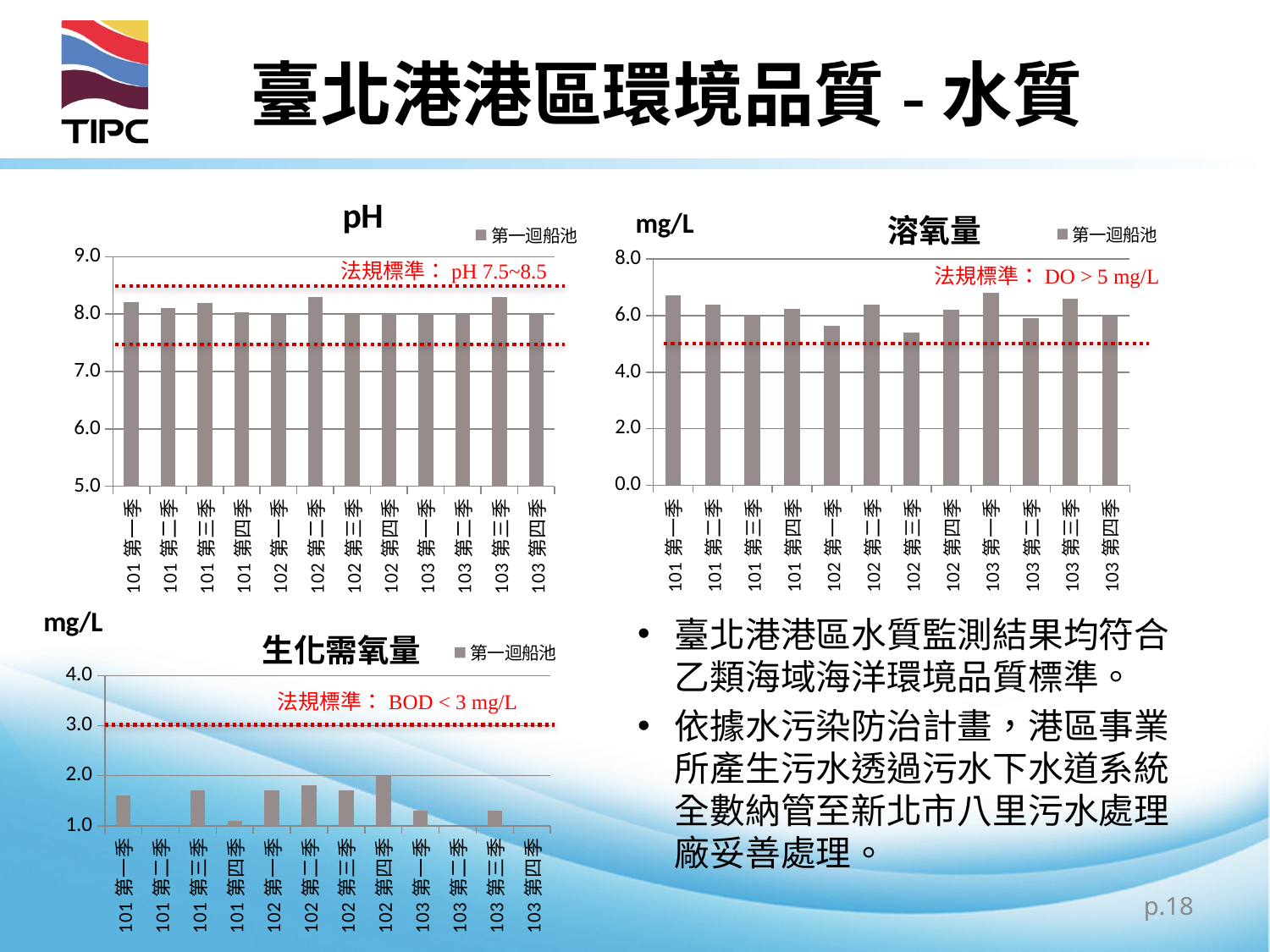
On the pH chart, is the value for 102 第二季 greater or less than 7.0? greater On the 生化需氧量 chart, is the value for 102 第四季 greater or less than 3.0? less On the 生化需氧量 chart, which quarter has the highest value? 102 第四季 On the 生化需氧量 chart, is the value for 101 第一季 greater or less than 1.0? greater How many series does the legend of the 生化需氧量 chart list? 1 What kind of chart is the pH chart? bar chart On the 溶氧量 chart, which quarter has the lowest value? 102 第三季 What is the legend entry shown on the pH chart? 第一迴船池 How many quarterly categories are plotted on the 溶氧量 chart? 12